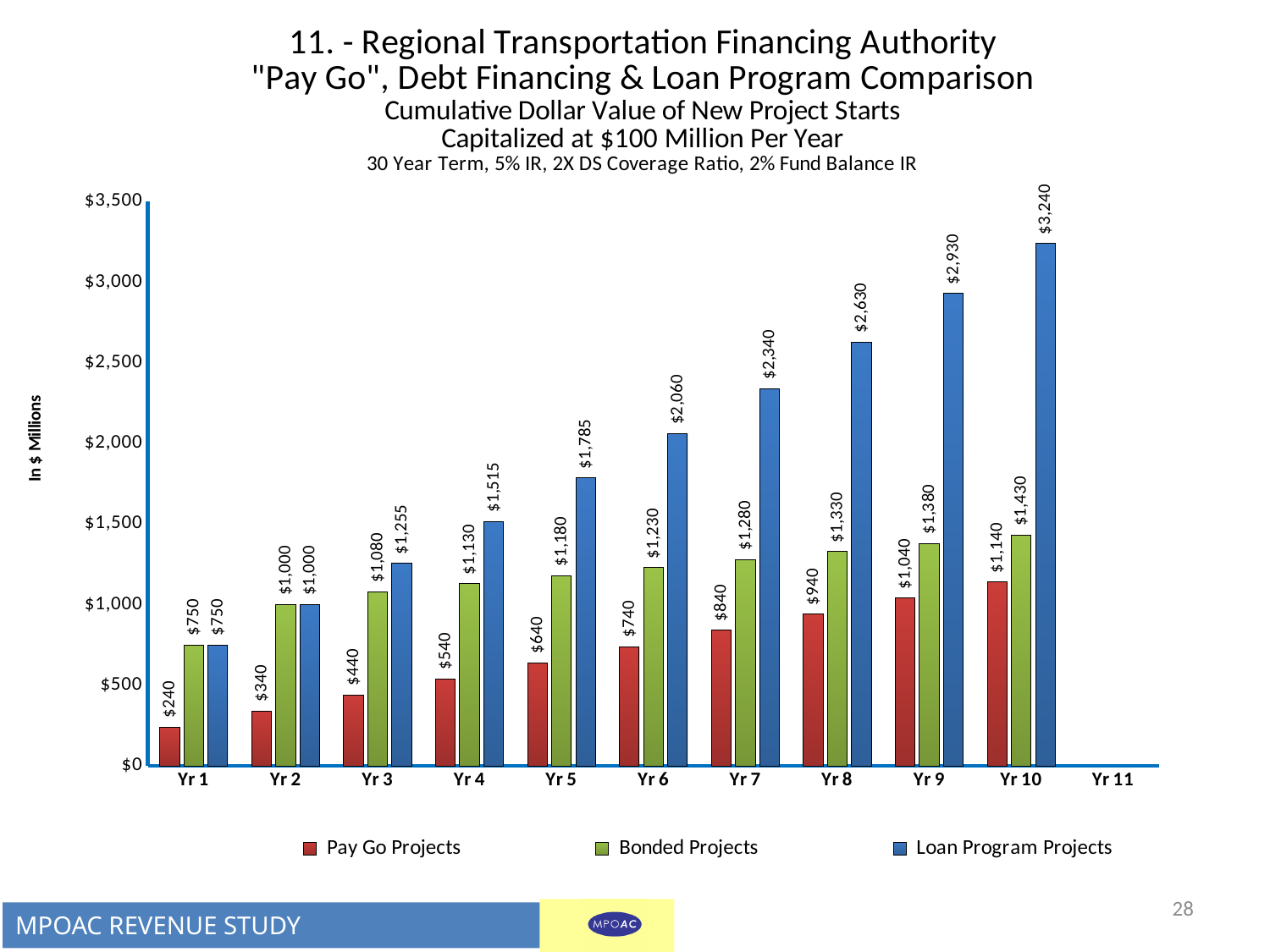
What kind of chart is shown on the slide? Bar chart What is the value for Bonded Projects in Yr 8? $1,330 Do the Pay Go Projects values rise or fall from Yr 1 to Yr 10? Rise Which is larger in Yr 7: Bonded Projects or Loan Program Projects? Loan Program Projects How many series does the legend list? 3 What is the difference between Bonded Projects and Pay Go Projects in Yr 3? $640 Is the value for Loan Program Projects in Yr 9 greater or less than $2,500? greater In which year is the Loan Program Projects value highest? Yr 10 In which year is the Pay Go Projects value lowest? Yr 1 What is the value for Pay Go Projects in Yr 5? $640 What is the value for Loan Program Projects in Yr 10? $3,240 What is the difference between Loan Program Projects and Bonded Projects in Yr 10? $1,810